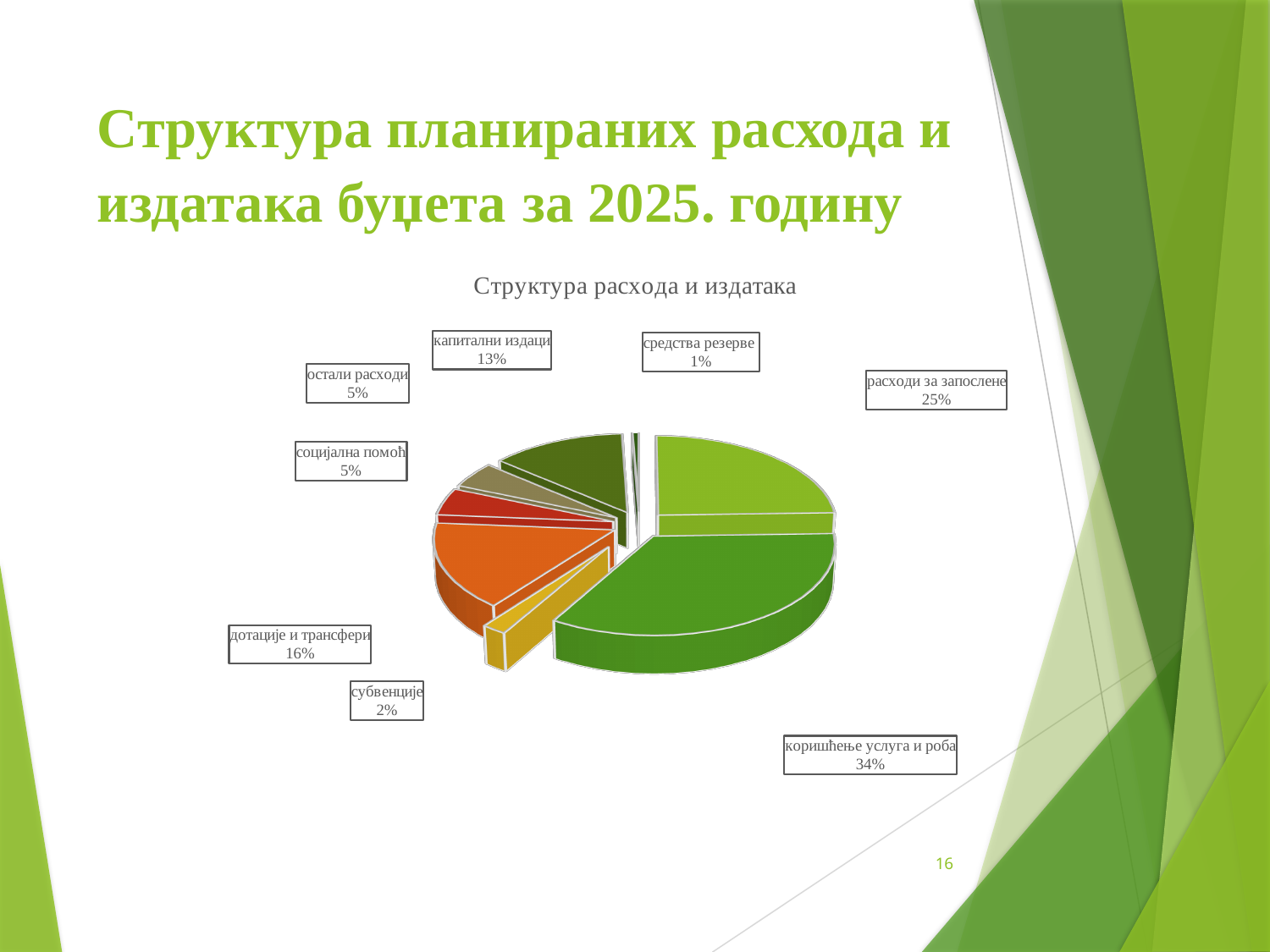
Which category has the smallest share of the pie? средства резерве What is the title of the chart? Структура расхода и издатака What percentage is shown for дотације и трансфери? 16% Which category has the largest share of the pie? коришћење услуга и роба What kind of chart is shown on the slide? pie chart Which is larger, the share for дотације и трансфери or the share for капитални издаци? дотације и трансфери What share of the pie is labelled for расходи за запослене? 25% What is the difference in percentage points between коришћење услуга и роба and расходи за запослене? 9 What share of the pie is labelled for коришћење услуга и роба? 34% What percentage is shown for субвенције? 2% What percentage is shown for капитални издаци? 13% How many categories (slices) does the pie chart have? 8